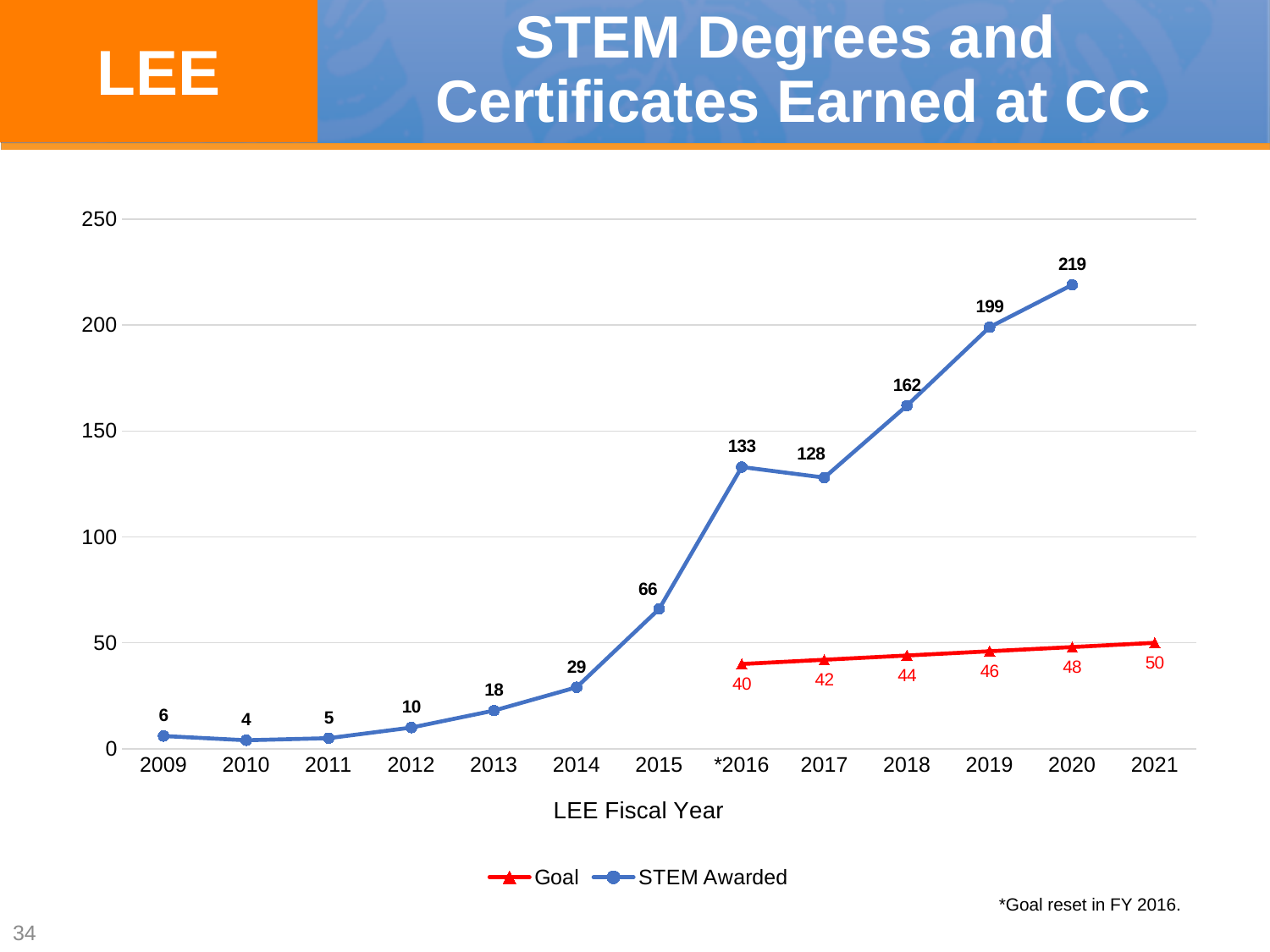
How many years are shown on the x axis? 13 Does the Goal series rise or fall from *2016 to 2021? rise Is the STEM Awarded value for 2018 greater or less than 150? greater Which is larger, the STEM Awarded value for *2016 or for 2017? *2016 What kind of chart is this? line chart What is the difference between the STEM Awarded values for 2020 and 2019? 20 Which year has the highest STEM Awarded value? 2020 How many series does the legend list? 2 What is the STEM Awarded value for 2015? 66 What is the STEM Awarded value for 2020? 219 Which year has the lowest STEM Awarded value? 2010 What is the Goal value for 2018? 44